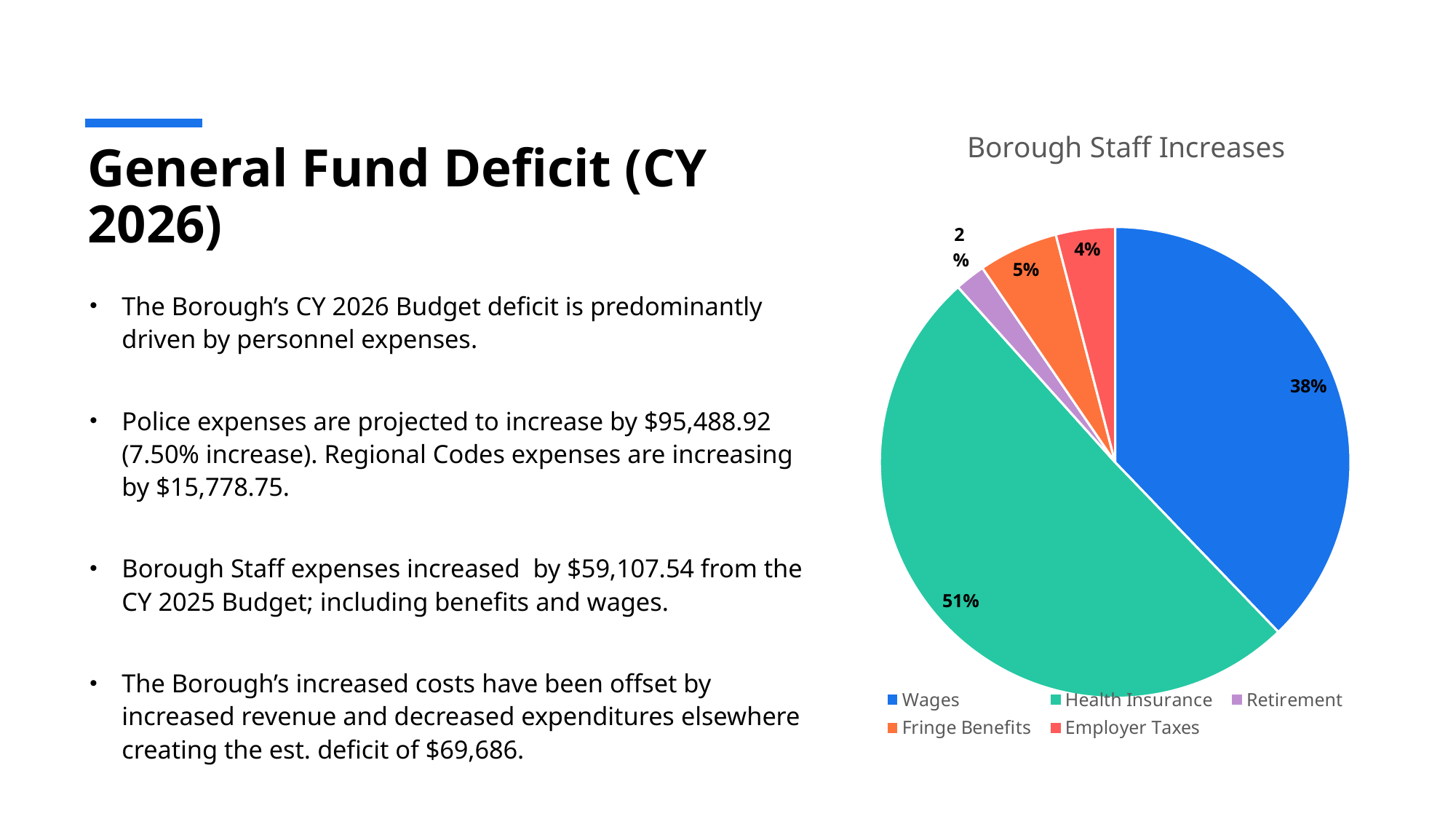
What share of the pie does Retirement represent? 2% Which category has the largest slice of the pie? Health Insurance Which category has the smallest slice of the pie? Retirement What share of the pie does Wages represent? 38% What type of chart is shown on the slide? pie chart What share of the pie does Employer Taxes represent? 4% What is the title of the chart? Borough Staff Increases How many categories does the pie chart show? 5 What is the difference in percentage points between the Health Insurance and Wages slices? 13 Which is larger, the Fringe Benefits slice or the Employer Taxes slice? Fringe Benefits